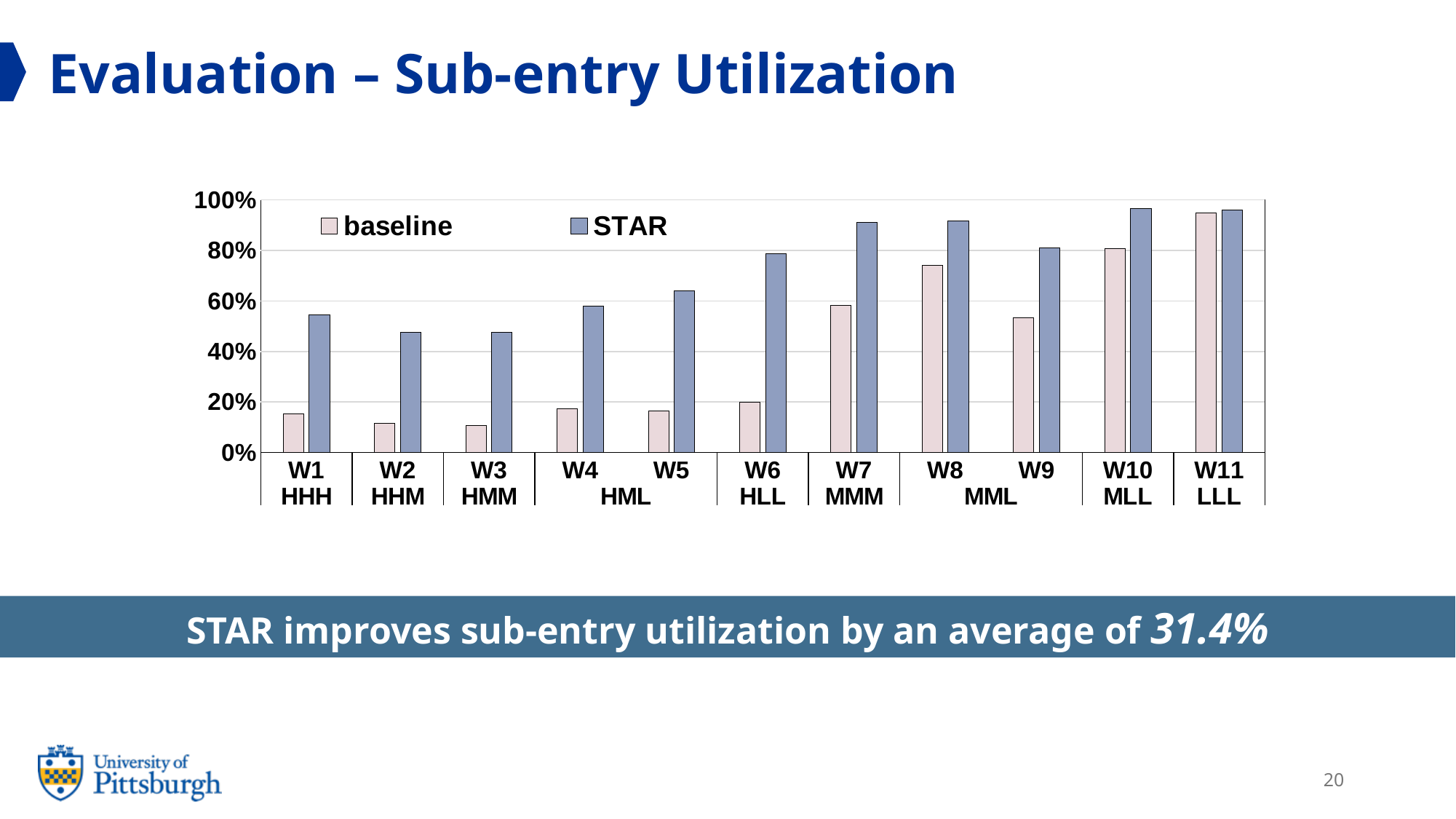
What are the two series named in the legend? baseline and STAR How many workloads (W1 to W11) are plotted on the x axis? 11 Is the STAR value for W2 greater or less than 60%? less How many series does the chart's legend list? 2 Is the STAR value for W7 greater or less than 80%? greater Which workload has the highest baseline sub-entry utilization? W11 What kind of chart is shown on the slide? bar chart Which has the larger baseline value, W8 or W9? W8 Is the baseline value for W8 greater or less than 60%? greater According to the slide's summary banner, by what average does STAR improve sub-entry utilization? 31.4% For W7, which series has the larger value, baseline or STAR? STAR